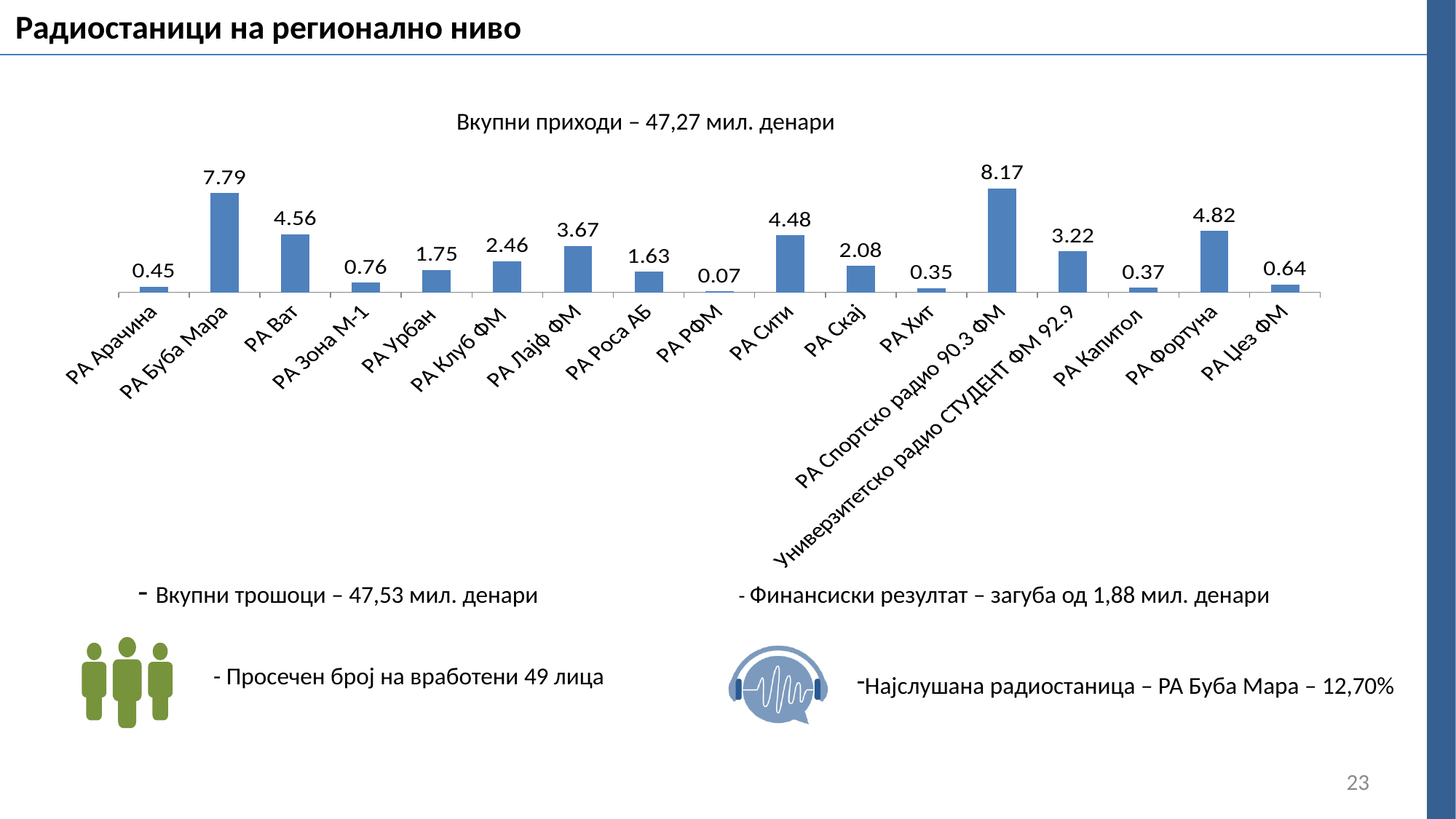
What is the value for Универзитетско радио СТУДЕНТ ФМ 92.9? 3.22 What kind of chart is shown on the slide? Bar chart What is the difference between the values for РА Спортско радио 90.3 ФМ and РА Буба Мара? 0.38 How many categories are shown in the chart? 17 Which is larger, the value for РА Ват or the value for РА Сити? РА Ват What is the value for РА Лајф ФМ? 3.67 What is the value for РА Спортско радио 90.3 ФМ? 8.17 What is the title of the chart? Вкупни приходи – 47,27 мил. денари What is the difference between the values for РА Фортуна and РА Клуб ФМ? 2.36 What is the value for РА Буба Мара? 7.79 Which category has the highest value? РА Спортско радио 90.3 ФМ Which category has the lowest value? РА РФМ